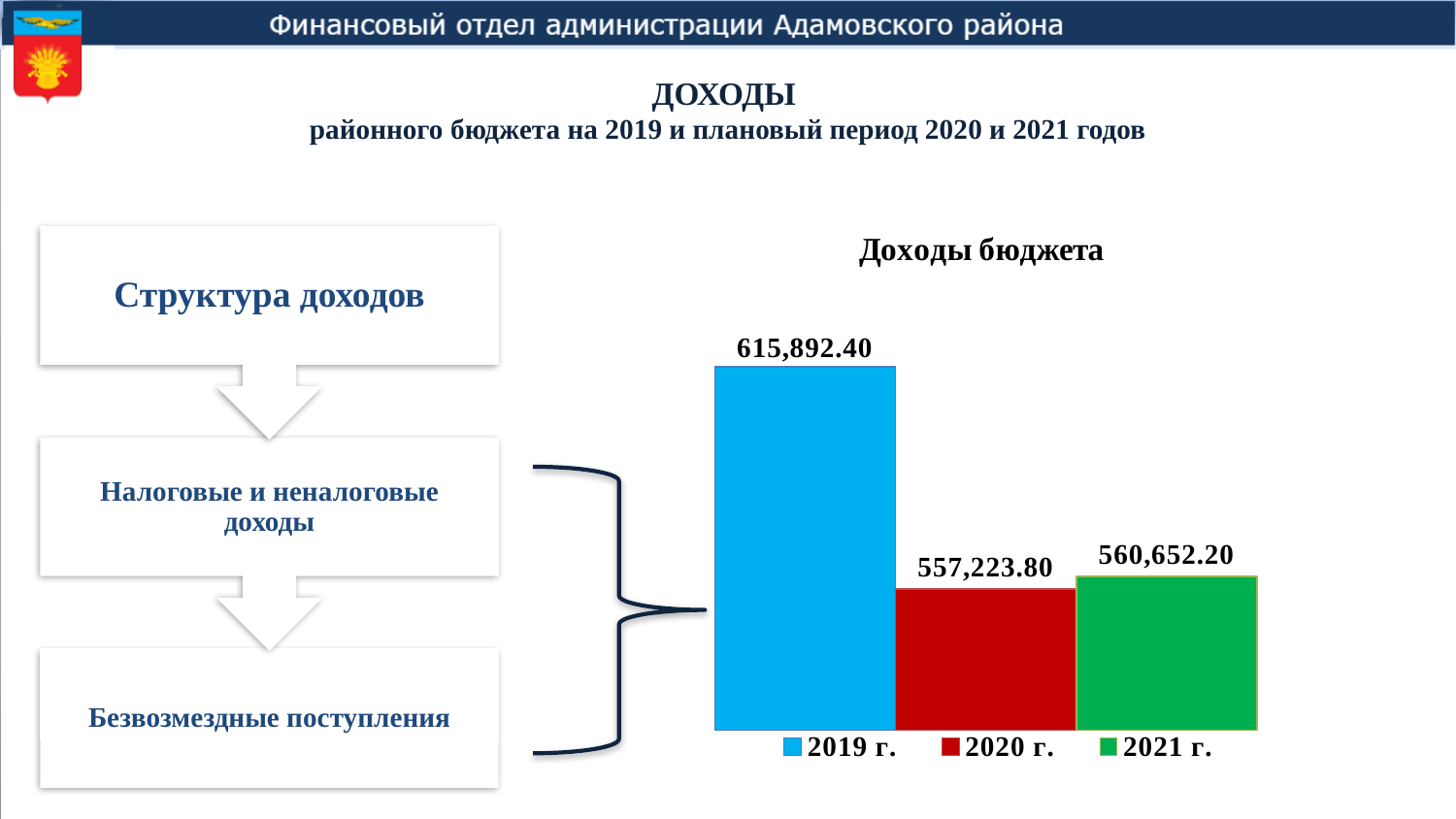
What is the value for 2019 г. in the Доходы бюджета chart? 615,892.40 What is the value for 2021 г. in the Доходы бюджета chart? 560,652.20 How many entries does the legend of the Доходы бюджета chart list? 3 What is the value for 2020 г. in the Доходы бюджета chart? 557,223.80 How many bars are shown in the Доходы бюджета chart? 3 Which year has the highest value in the Доходы бюджета chart? 2019 г. What colour is the bar for 2020 г. in the Доходы бюджета chart? red What is the difference between the values for 2019 г. and 2020 г. in the Доходы бюджета chart? 58,668.60 What kind of chart is the Доходы бюджета chart? bar chart What is the difference between the values for 2021 г. and 2020 г. in the Доходы бюджета chart? 3,428.40 Which year has the lowest value in the Доходы бюджета chart? 2020 г. Which is larger in the Доходы бюджета chart, the value for 2020 г. or 2021 г.? 2021 г.